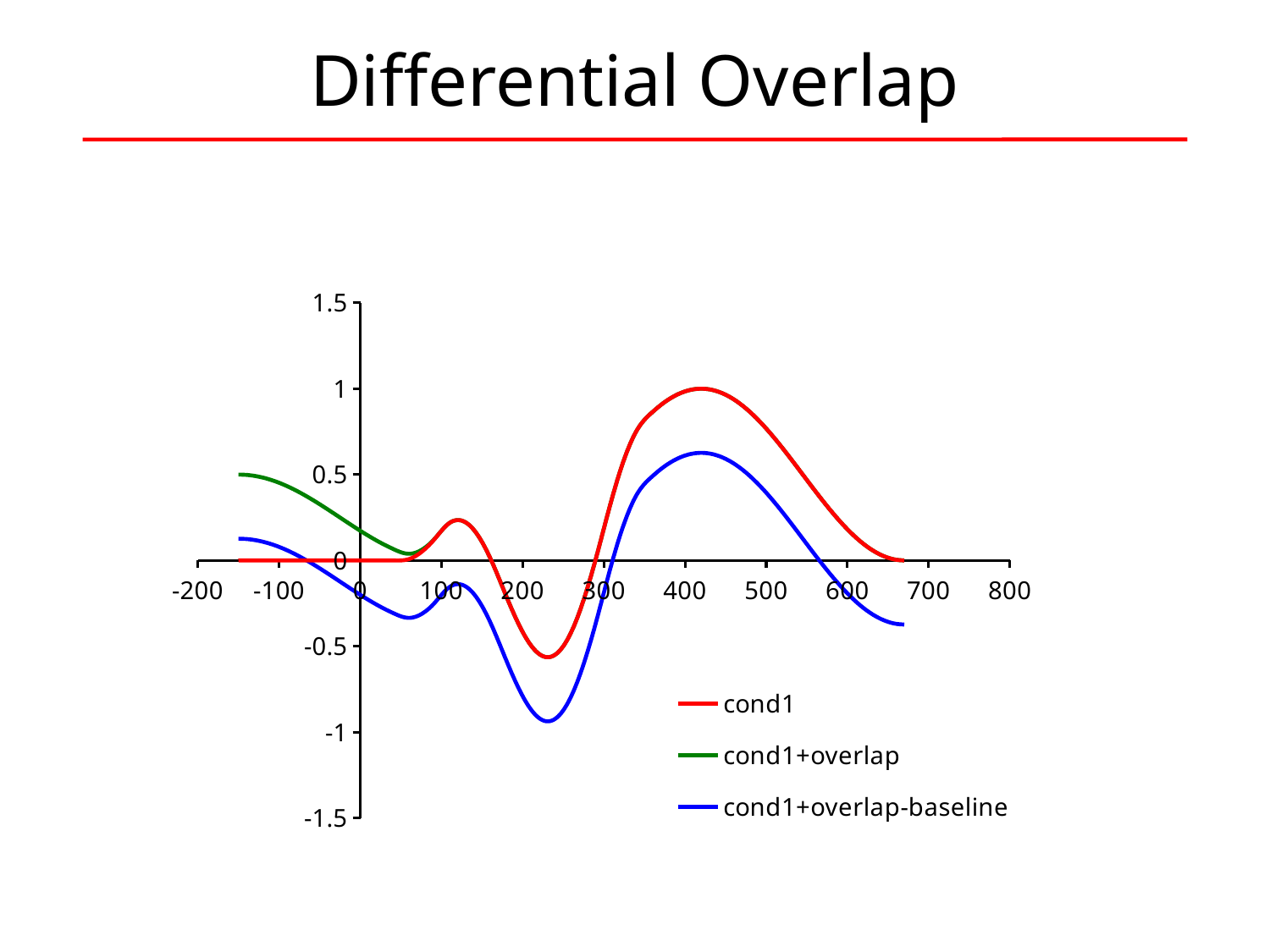
Is the lowest value of cond1+overlap-baseline near x = 230 greater or less than -0.5? less Around x = 400, which series has the higher peak, cond1 or cond1+overlap-baseline? cond1 Does the cond1+overlap line rise or fall as x goes from -150 to 50? fall Which series reaches the lowest value anywhere on the chart? cond1+overlap-baseline Is the lowest value of cond1 near x = 230 greater or less than -1? greater Is the peak value of cond1 near x = 400 greater or less than 0.5? greater What kind of chart is shown on the slide? line chart What is the title of the chart? Differential Overlap What colour is the cond1+overlap-baseline line? blue How many series does the legend list? 3